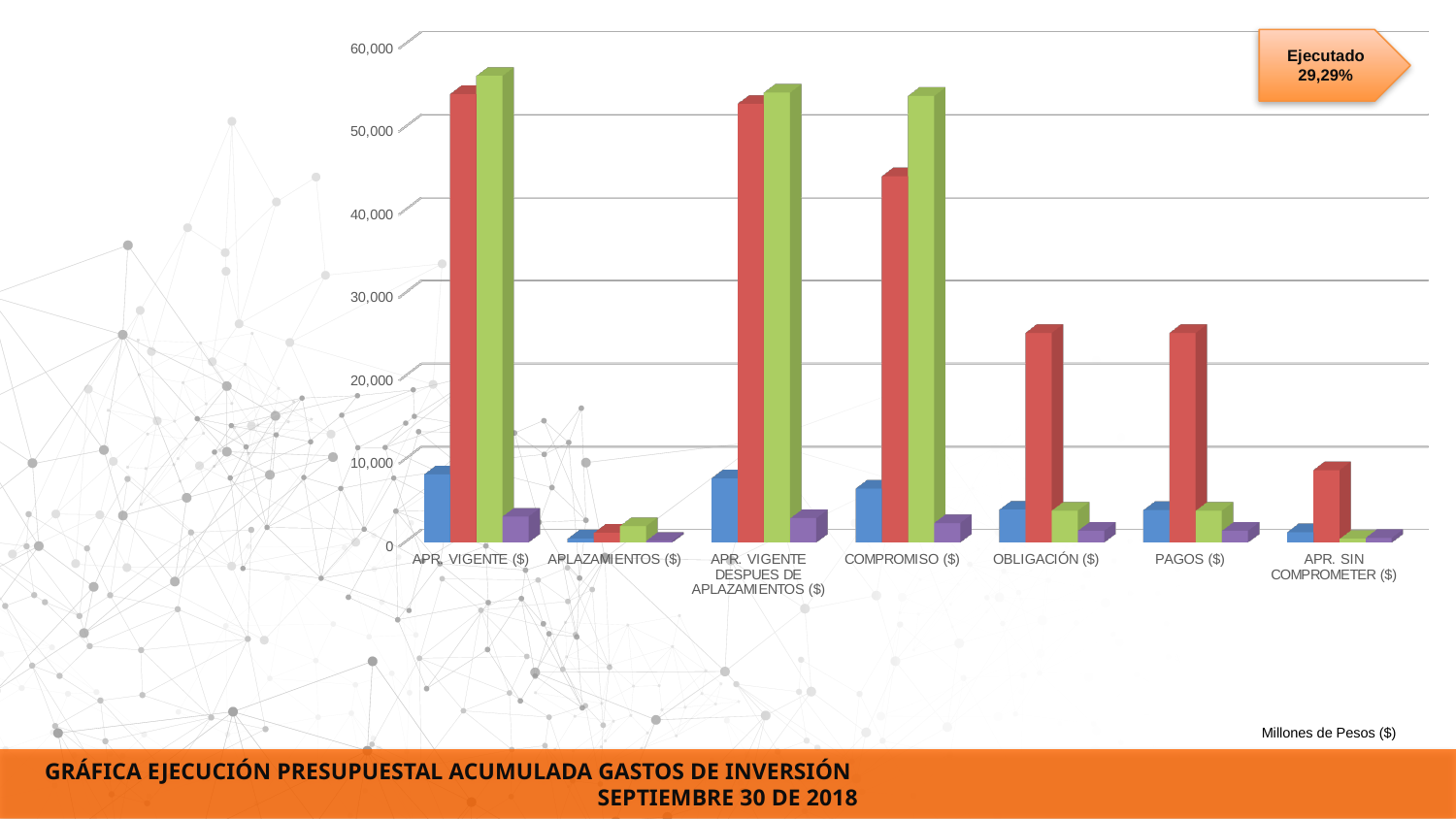
Is the red bar for OBLIGACIÓN ($) greater or less than 20,000? greater Is the red bar for APR. SIN COMPROMETER ($) greater or less than 10,000? less Which is larger, the red bar for COMPROMISO ($) or the red bar for OBLIGACIÓN ($)? COMPROMISO ($) Is the red bar for COMPROMISO ($) greater or less than 50,000? less How many categories are shown on the x axis of the chart? 7 Which category has the lowest red bar? APLAZAMIENTOS ($) What unit is stated below the chart? Millones de Pesos ($) What percentage is shown in the 'Ejecutado' callout on the chart? 29,29% What kind of chart is shown on the slide? bar chart